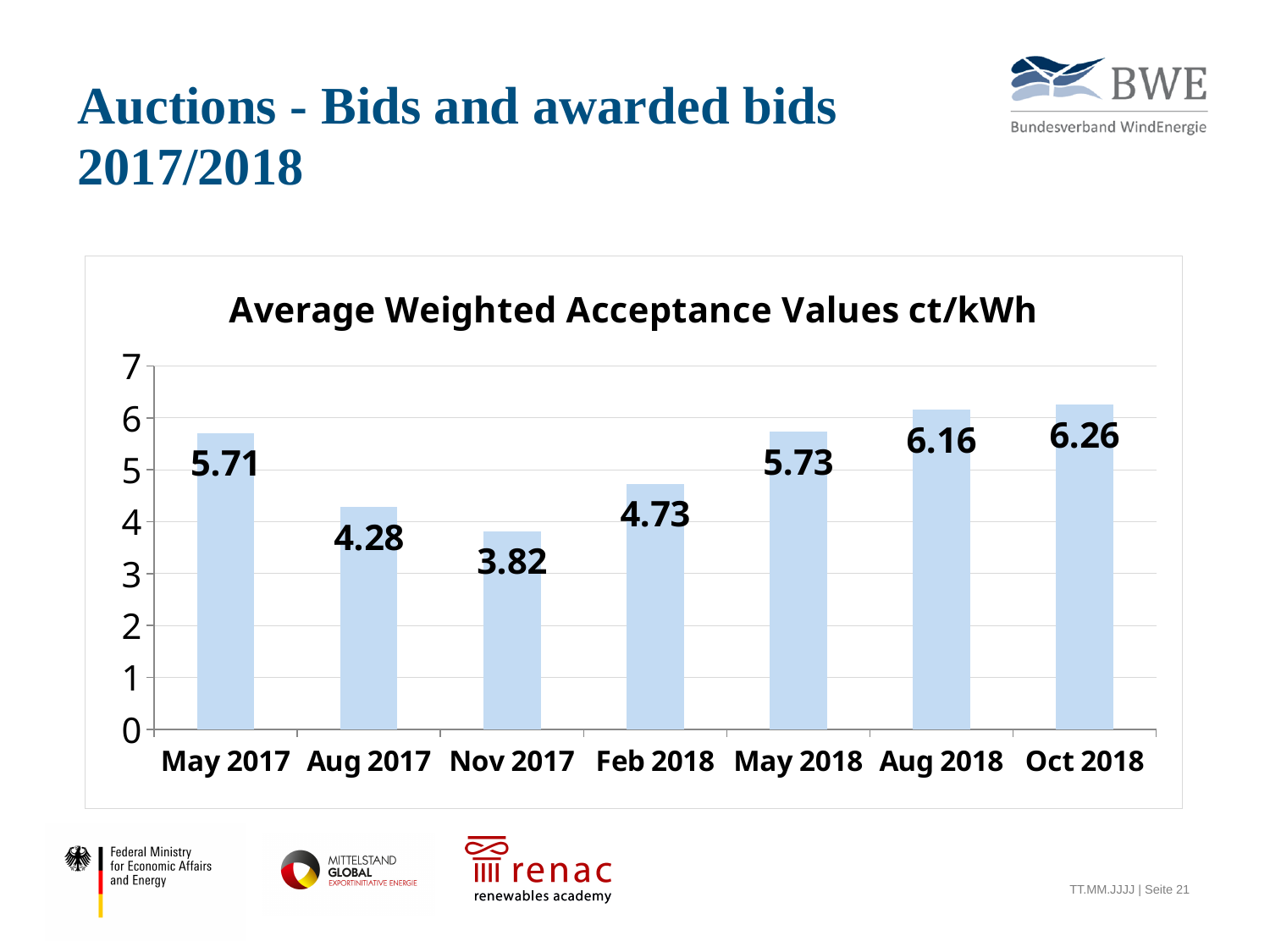
What is the average weighted acceptance value for Aug 2018? 6.16 Is the value for Aug 2017 greater or less than 5? less What is the difference between the values for Oct 2018 and Nov 2017? 2.44 Which auction round has the highest average weighted acceptance value? Oct 2018 How many auction rounds are shown on the x axis? 7 What is the average weighted acceptance value for Nov 2017? 3.82 What kind of chart is shown on the slide? bar chart What is the difference between the values for May 2018 and May 2017? 0.02 Which auction round has the lowest average weighted acceptance value? Nov 2017 Do the values rise or fall from Nov 2017 to Oct 2018? rise Which is larger, the value for May 2017 or the value for Feb 2018? May 2017 What is the title of the chart? Average Weighted Acceptance Values ct/kWh